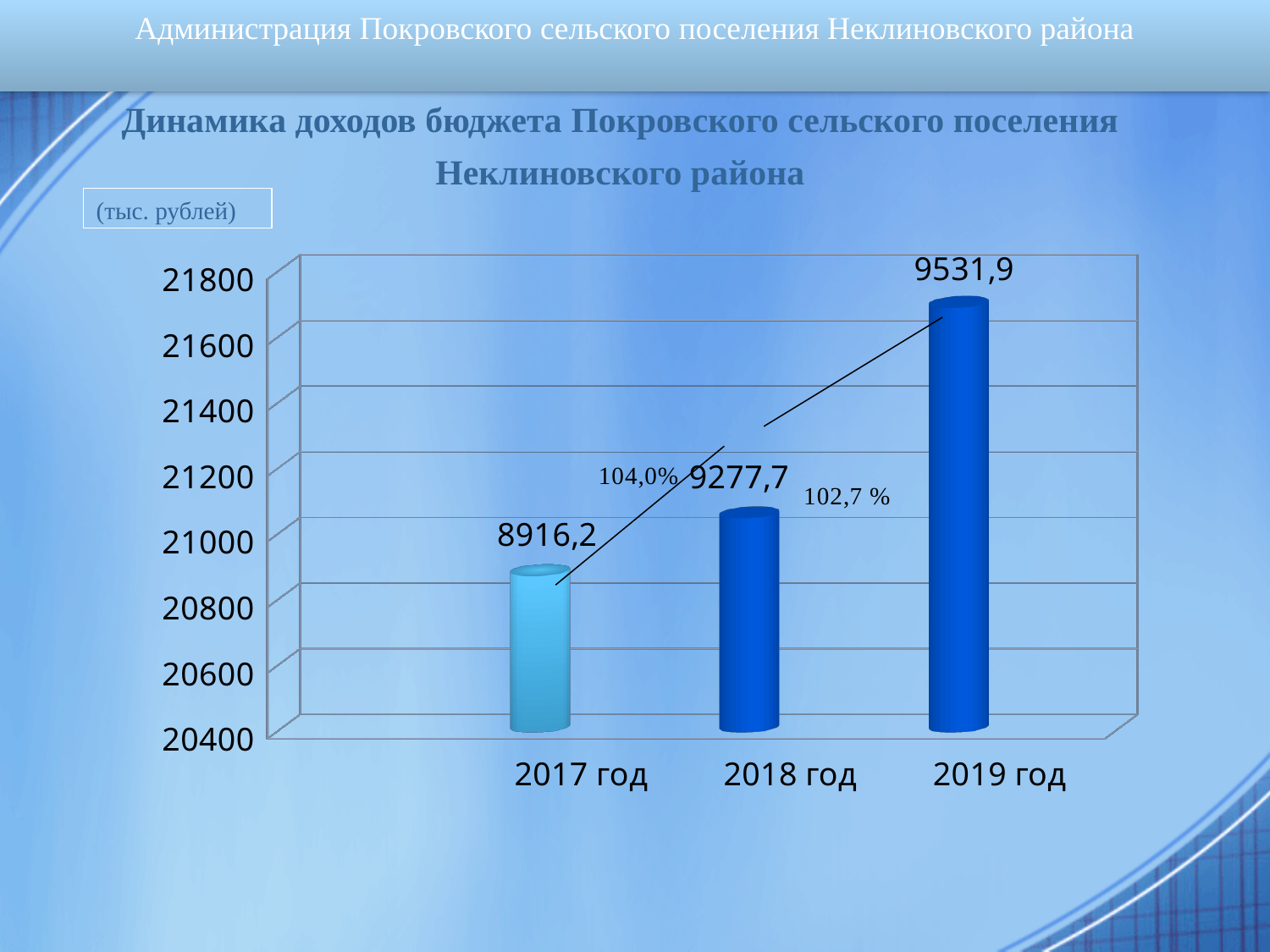
Which is larger, the value for 2018 год or the value for 2019 год? 2019 год How many years are shown on the chart? 3 Do the values rise or fall from 2017 год to 2019 год? rise Which year has the lowest value? 2017 год What kind of chart is this? bar chart What unit is stated for the chart values? тыс. рублей Which year has the highest value? 2019 год